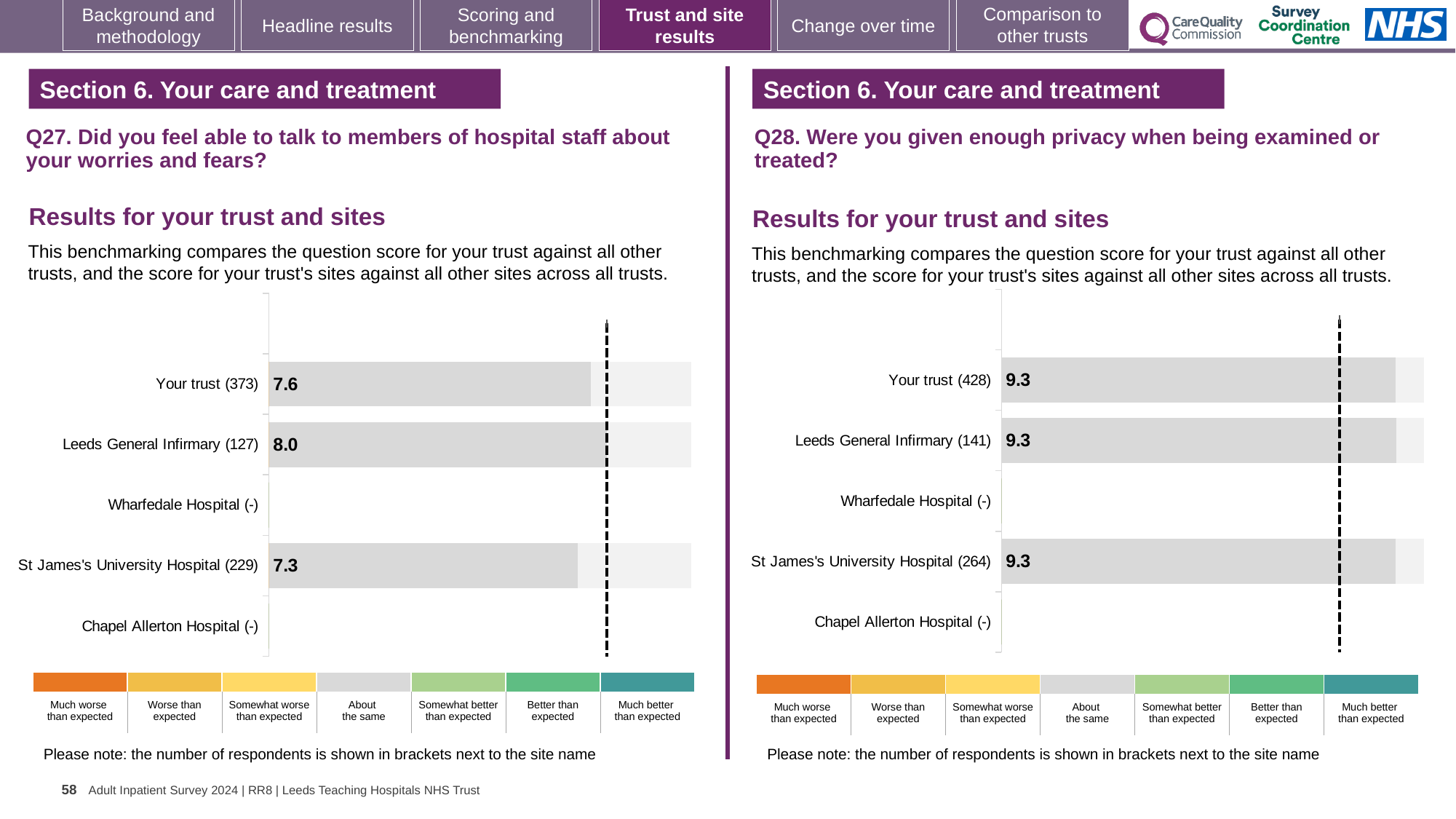
On the Q27 chart (left), what is the score for Leeds General Infirmary? 8.0 On the Q27 chart (left), what is the score for St James's University Hospital? 7.3 On the Q28 chart (right), what is the score for Your trust? 9.3 On the Q27 chart (left), what is the score for Your trust? 7.6 On the Q27 chart (left), which site with a plotted score has the lowest value? St James's University Hospital What kind of chart is used on the Q28 chart (right)? Bar chart On the Q27 chart (left), which site with a plotted score has the highest value? Leeds General Infirmary How many site/trust categories are listed on the Q27 chart (left)? 5 On the Q28 chart (right), what is the score for St James's University Hospital? 9.3 On the Q27 chart (left), what is the difference between the scores for Leeds General Infirmary and St James's University Hospital? 0.7 On the Q27 chart (left), which is larger: the score for Your trust or the score for Leeds General Infirmary? Leeds General Infirmary On the Q28 chart (right), how many respondents are shown in brackets for Leeds General Infirmary? 141